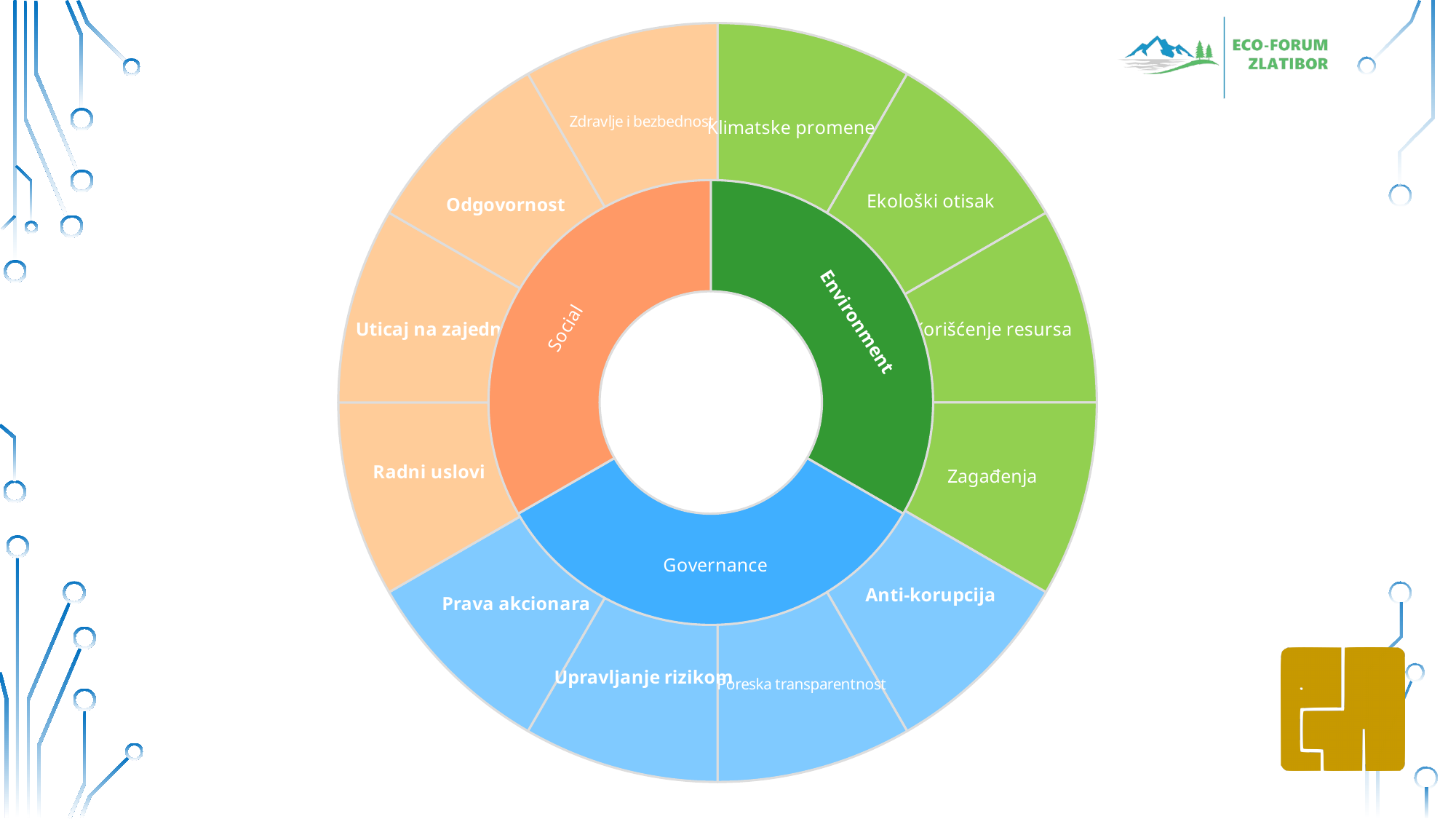
What are the three categories in the inner ring of the chart? Environment, Social, Governance Which inner-ring category does the segment 'Anti-korupcija' belong to? Governance How many outer-ring segments belong to the Social category? 4 Which inner-ring category does the segment 'Ekološki otisak' belong to? Environment How many outer-ring segments belong to the Governance category? 4 How many outer-ring segments belong to the Environment category? 4 What colour is the Governance segment in the inner ring of the chart? Blue What kind of chart is shown on the slide? Doughnut chart Which inner-ring category does the segment 'Radni uslovi' belong to? Social Which inner-ring category does the segment 'Zagađenja' belong to? Environment